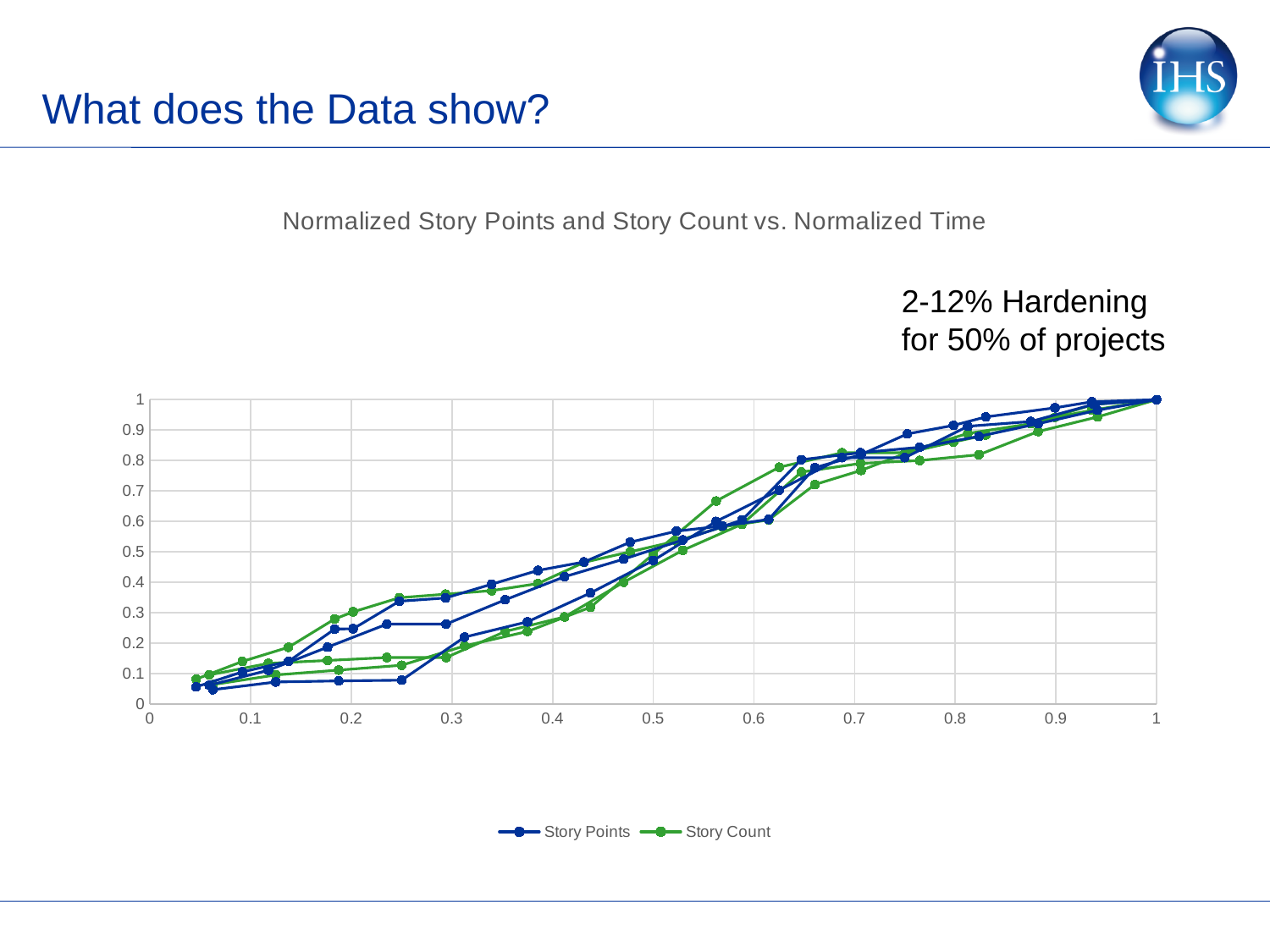
At normalized time 0.5, are the Story Count values greater or less than 0.6? less Do the lines rise or fall as normalized time increases from 0 to 1? rise What kind of chart is shown on the slide? line chart Which series is drawn in green? Story Count At normalized time 0.9, are the Story Count values greater or less than 0.8? greater What is the title of the chart? Normalized Story Points and Story Count vs. Normalized Time What value do all the lines reach at normalized time 1? 1 What is the highest value shown on the y axis? 1 At normalized time 0.3, are the Story Points values greater or less than 0.5? less How many series does the chart legend list? 2